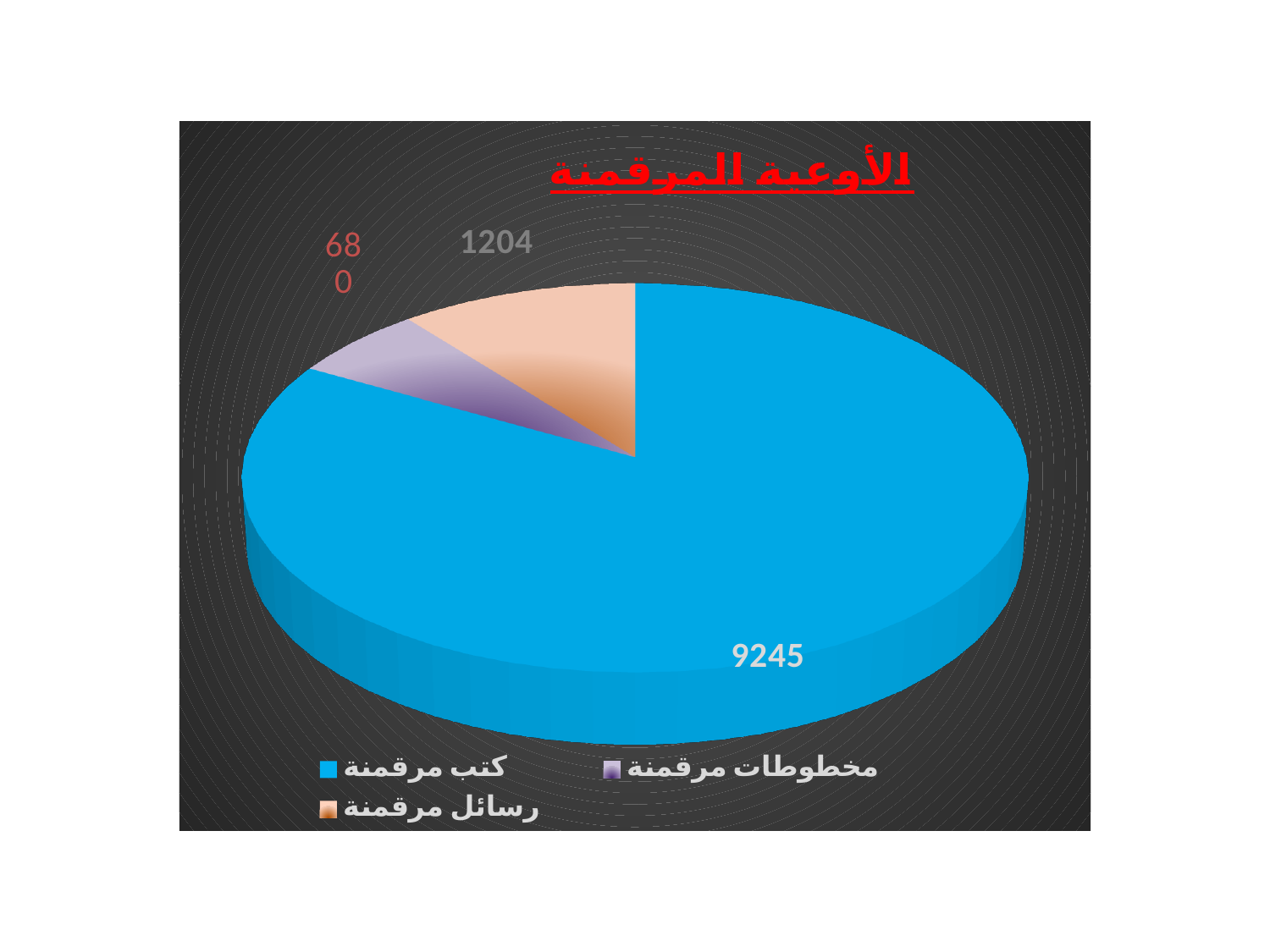
Which is larger, the value for رسائل مرقمنة or the value for مخطوطات مرقمنة? رسائل مرقمنة What colour is the slice for كتب مرقمنة? blue How many series does the legend list? 3 What is the value for كتب مرقمنة? 9245 Which category has the smallest slice? مخطوطات مرقمنة What is the difference between the values for كتب مرقمنة and رسائل مرقمنة? 8041 How many slices does the pie chart have? 3 What type of chart is shown on the slide? pie chart What is the value for رسائل مرقمنة? 1204 What is the title of the chart? الأوعية المرقمنة What is the value for مخطوطات مرقمنة? 680 Which category has the largest slice? كتب مرقمنة